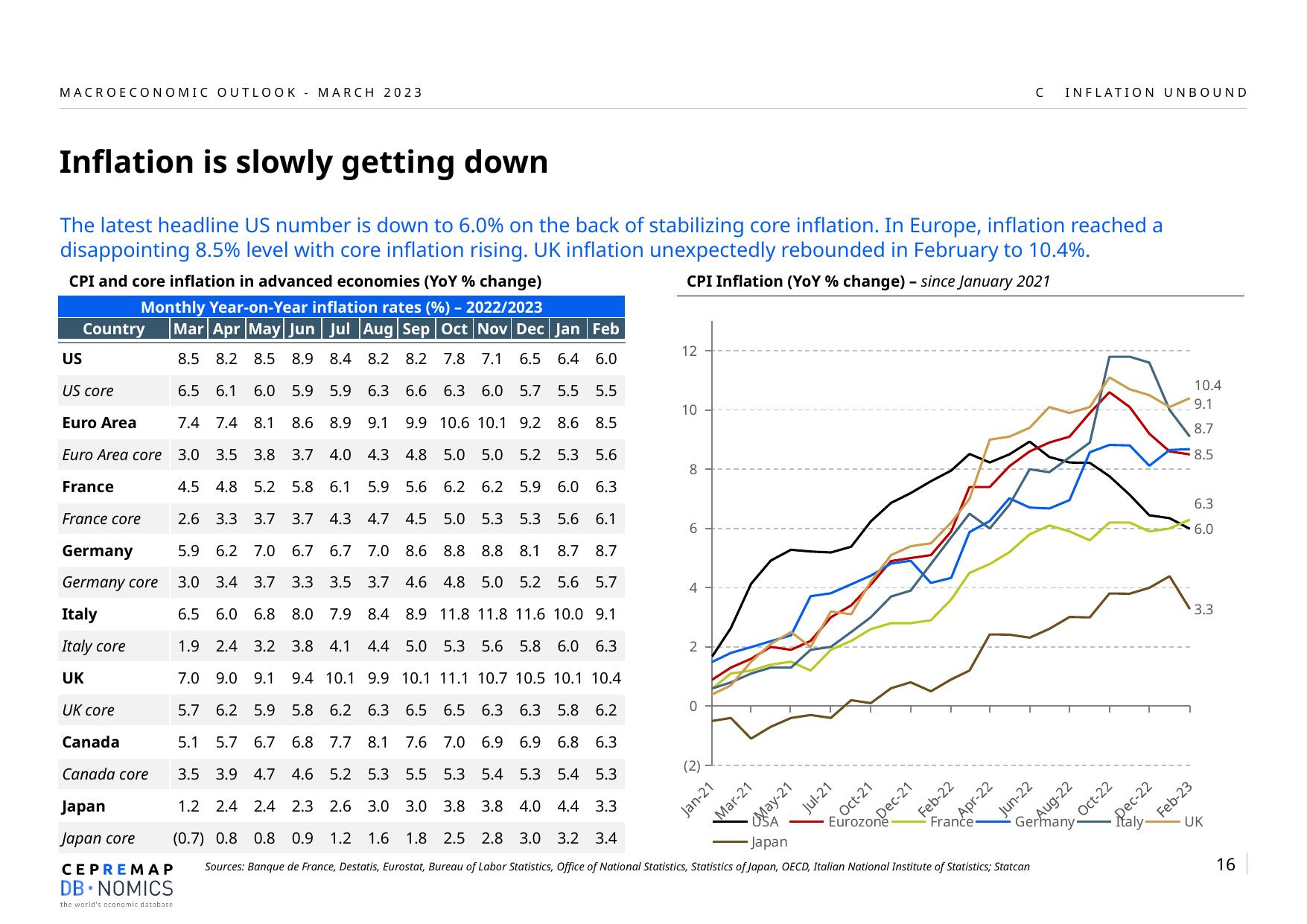
In the CPI Inflation chart, is the peak value of the Italy line greater or less than 10? greater In the CPI Inflation chart, what is the latest labelled value for the UK? 10.4 In the CPI Inflation chart, which has the larger latest labelled value, Germany or the Eurozone? Germany Which country has the highest labelled value at the end of the CPI Inflation chart? UK What is the title of the line chart on the slide? CPI Inflation (YoY % change) – since January 2021 Which country has the lowest labelled value at the end of the CPI Inflation chart? Japan What kind of chart is shown on the slide? line chart In the CPI Inflation chart, what is the latest labelled value for the USA? 6.0 In the CPI Inflation chart, does the USA line rise or fall between Jun-22 and Feb-23? fall In the CPI Inflation chart, what is the difference between the latest labelled values for the UK and Japan? 7.1 How many series does the legend of the CPI Inflation chart list? 7 In the CPI Inflation chart, what is the latest labelled value for Japan? 3.3